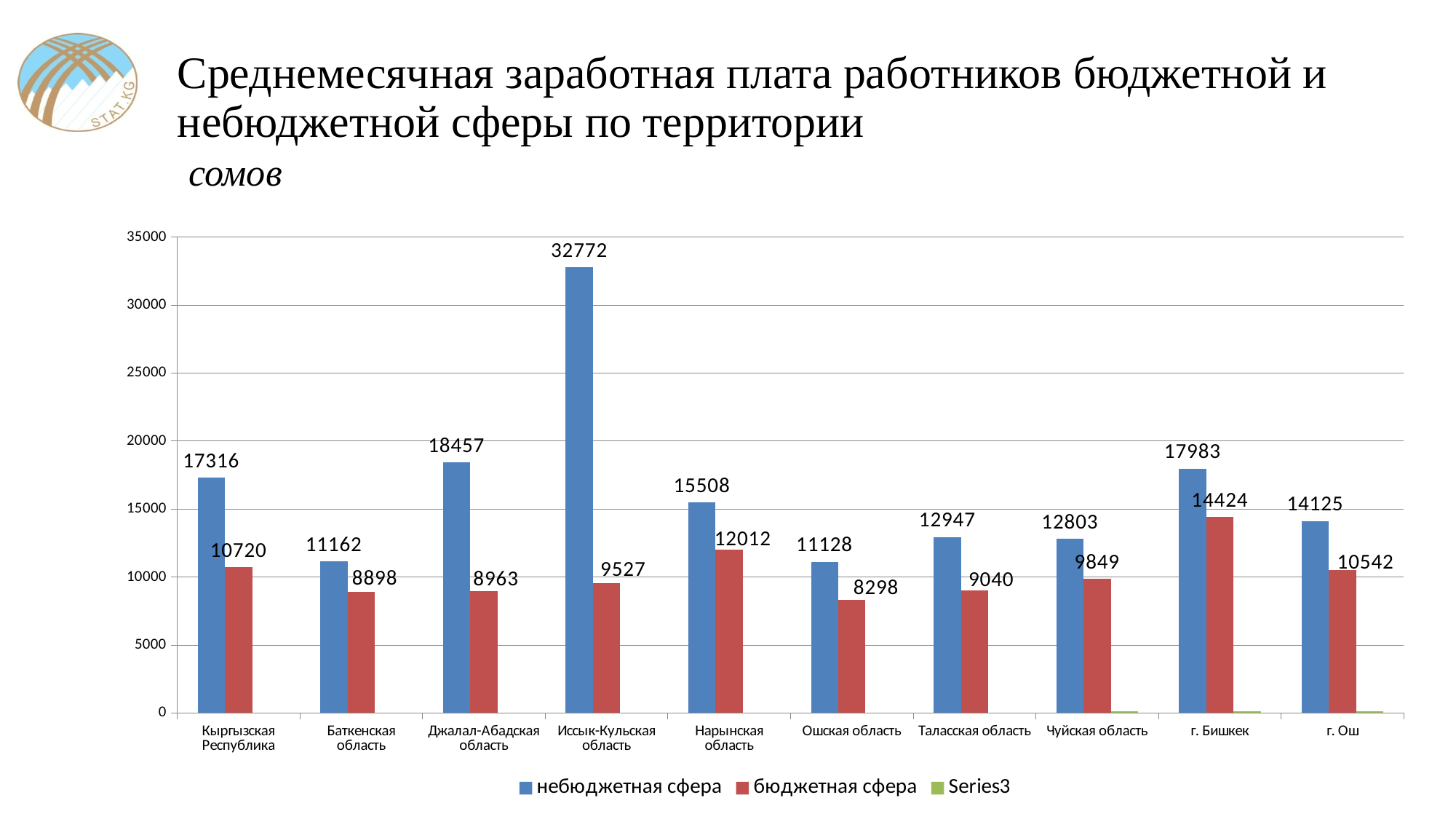
What kind of chart is shown on the slide? bar chart What is the value for бюджетная сфера in г. Бишкек? 14424 What is the difference between небюджетная сфера and бюджетная сфера in Иссык-Кульская область? 23245 What is the value for небюджетная сфера in Иссык-Кульская область? 32772 What is the value for бюджетная сфера in Ошская область? 8298 Is the value for небюджетная сфера in Джалал-Абадская область greater or less than 20000? less How many territories are shown on the x axis? 10 Which territory has the highest value for небюджетная сфера? Иссык-Кульская область How many series does the legend list? 3 Which territory has the lowest value for бюджетная сфера? Ошская область Which is larger in Нарынская область: небюджетная сфера or бюджетная сфера? небюджетная сфера Which territory has the highest value for бюджетная сфера? г. Бишкек